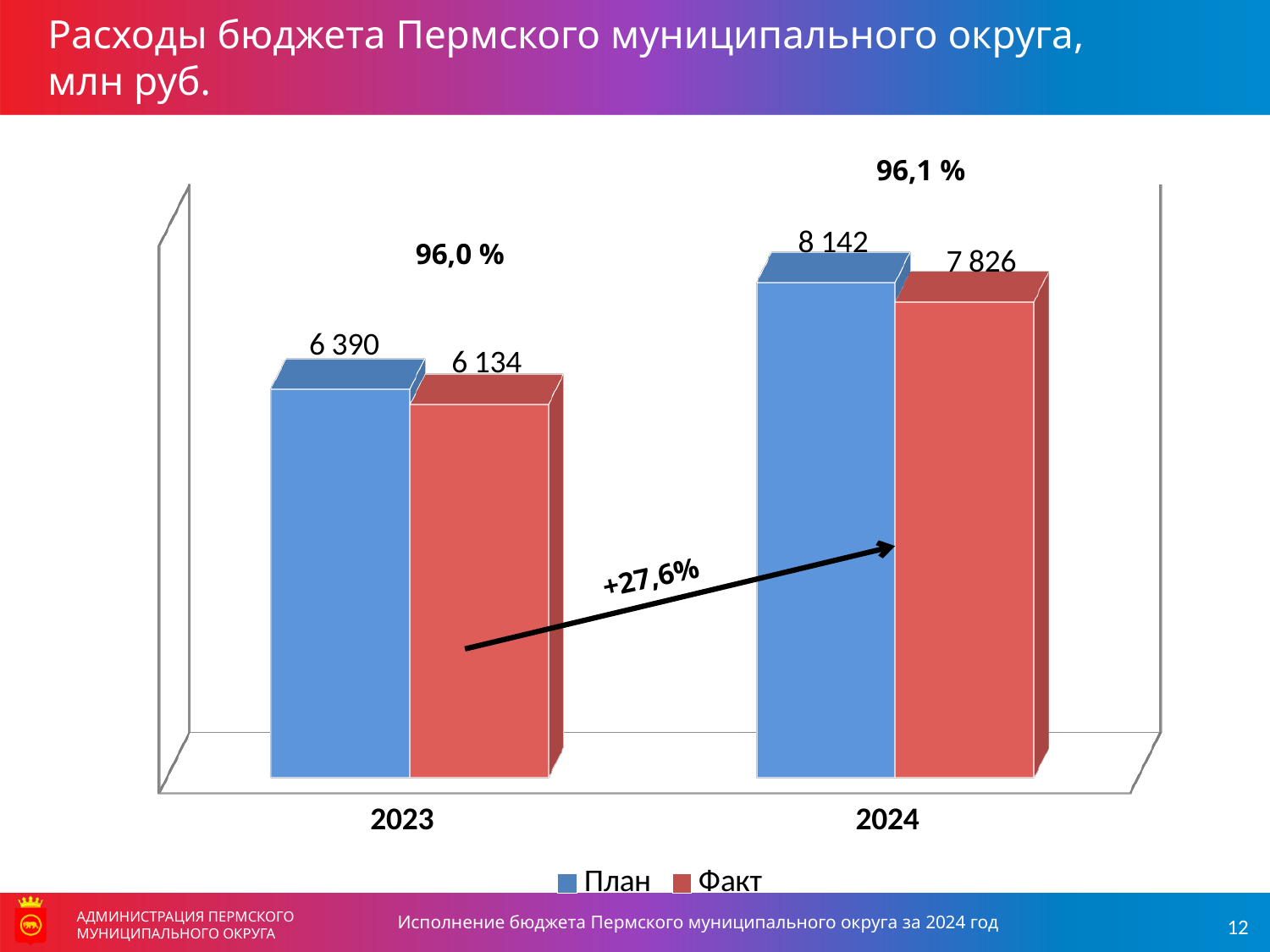
Which is larger in 2023, План or Факт? План What is the difference between План and Факт in 2023? 256 What is the План value for 2024? 8 142 What is the Факт value for 2023? 6 134 How many years are shown on the x axis? 2 What is the difference between План and Факт in 2024? 316 What is the План value for 2023? 6 390 What is the Факт value for 2024? 7 826 What kind of chart is shown on the slide? Bar chart How many series does the legend list? 2 What percentage growth is shown by the arrow between 2023 and 2024? +27,6% Which year has the higher Факт value? 2024